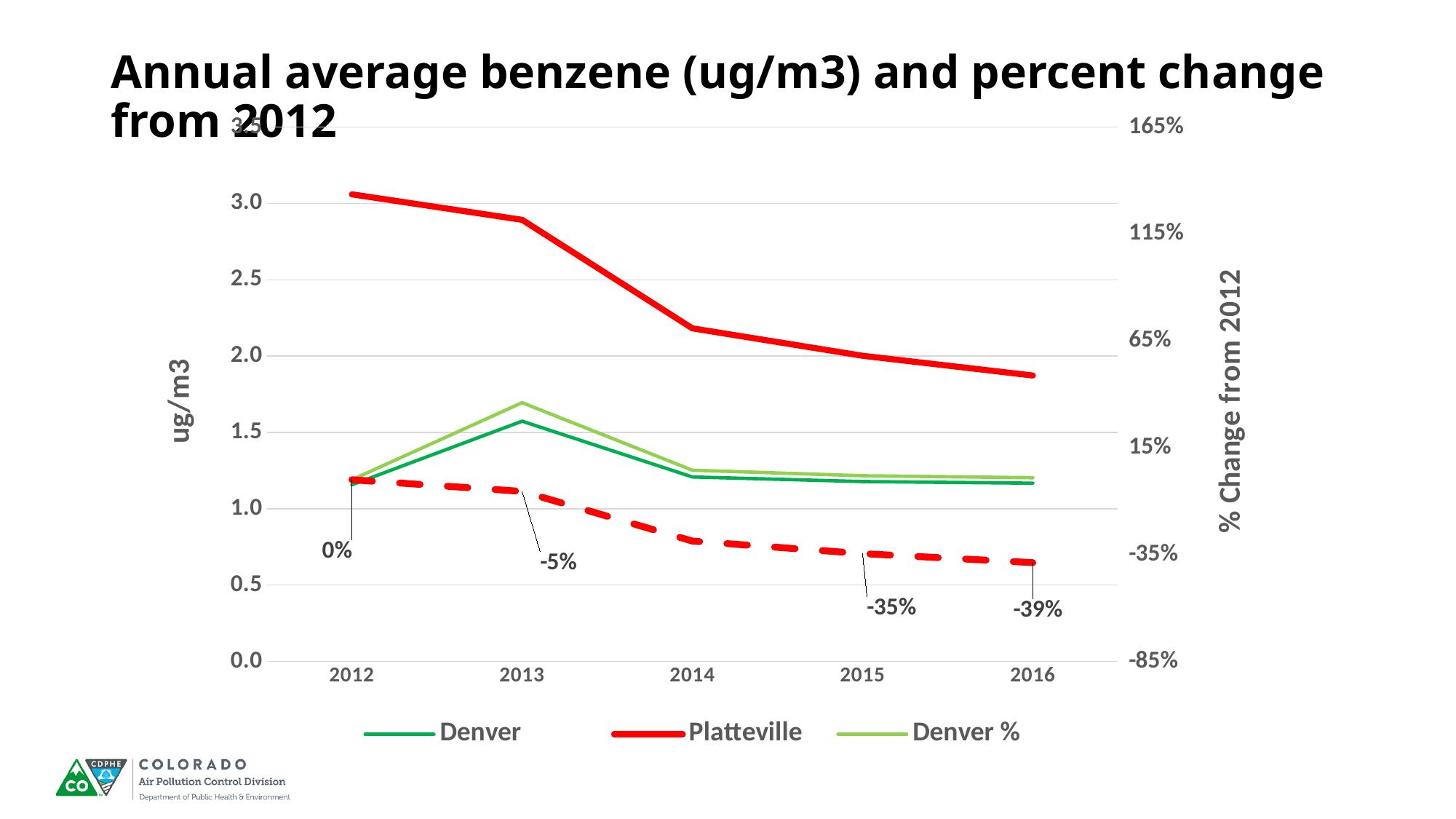
What percent change is labelled on the dashed red line for 2015? -35% What is the title of the right-hand vertical axis? % Change from 2012 What is the difference in percentage points between the labelled values for 2013 (-5%) and 2016 (-39%) on the dashed red line? 34 How many years are plotted along the x axis? 5 In which year is the Platteville line at its highest? 2012 Does the Platteville line rise or fall from 2012 to 2016? fall What kind of chart is shown on the slide? line chart Is the Platteville value for 2014 greater or less than 2.5 ug/m3? less How many series does the legend list? 3 Is the Platteville value for 2016 greater or less than 2.0 ug/m3? less What percent change is labelled on the dashed red line for 2016? -39% What percent change is labelled on the dashed red line for 2013? -5%